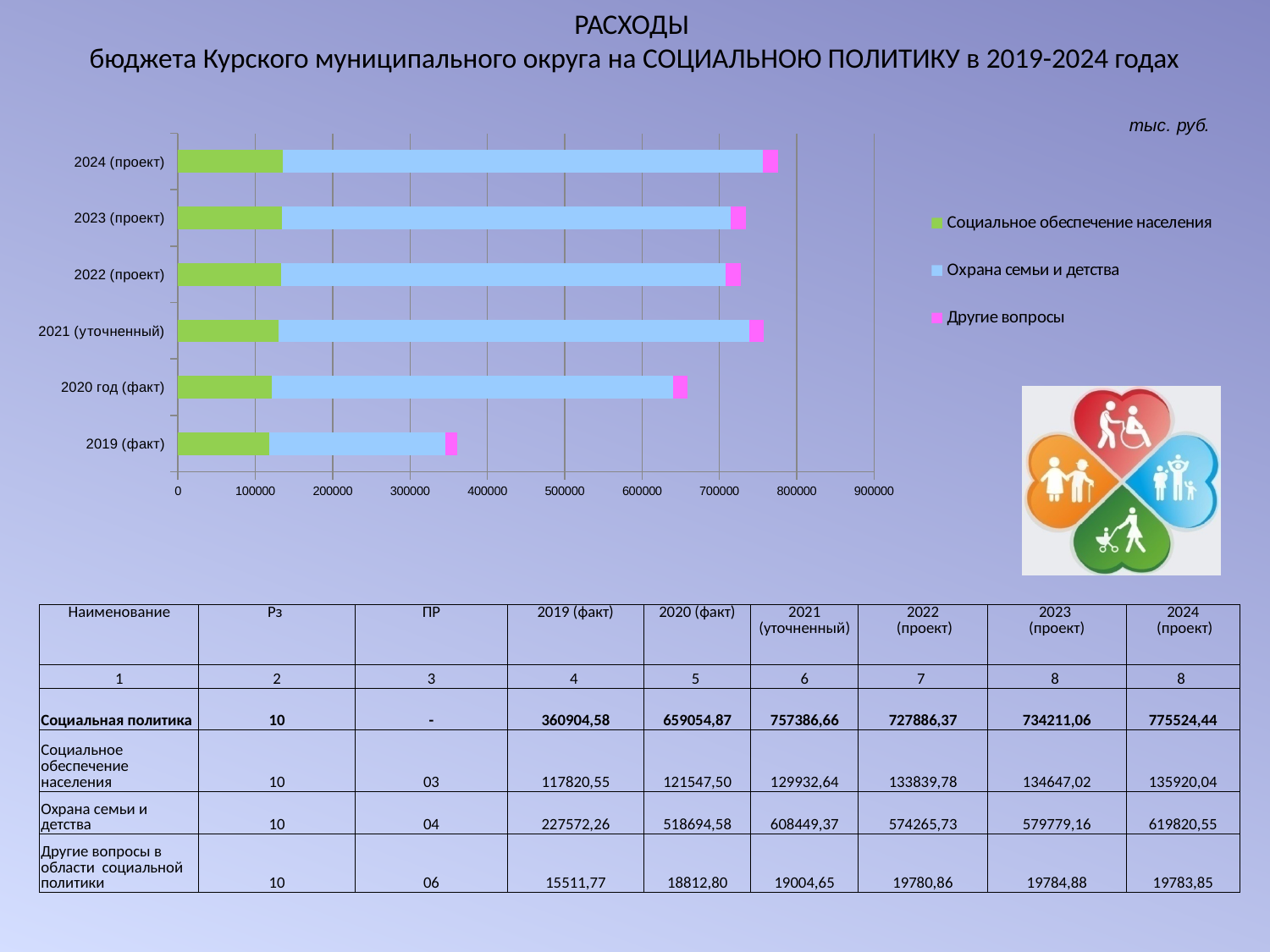
Which year has the shortest total bar on the chart? 2019 (факт) Which year has the longest total bar on the chart? 2024 (проект) How many year categories are plotted on the chart? 6 Is the total bar for 2020 год (факт) greater or less than 600000? greater What is the difference between Социальное обеспечение населения in 2024 (проект) and in 2019 (факт)? 18099,49 Is the total bar for 2019 (факт) greater or less than 400000? less What kind of chart is shown on the slide? Stacked horizontal bar chart What colour represents Другие вопросы in the chart legend? Pink (magenta) What is the value of Охрана семьи и детства for 2021 (уточненный)? 608449,37 What is the total of the stacked bar for 2024 (проект)? 775524,44 How many series does the chart legend list? 3 Which is larger for Охрана семьи и детства: 2020 (факт) or 2021 (уточненный)? 2021 (уточненный)